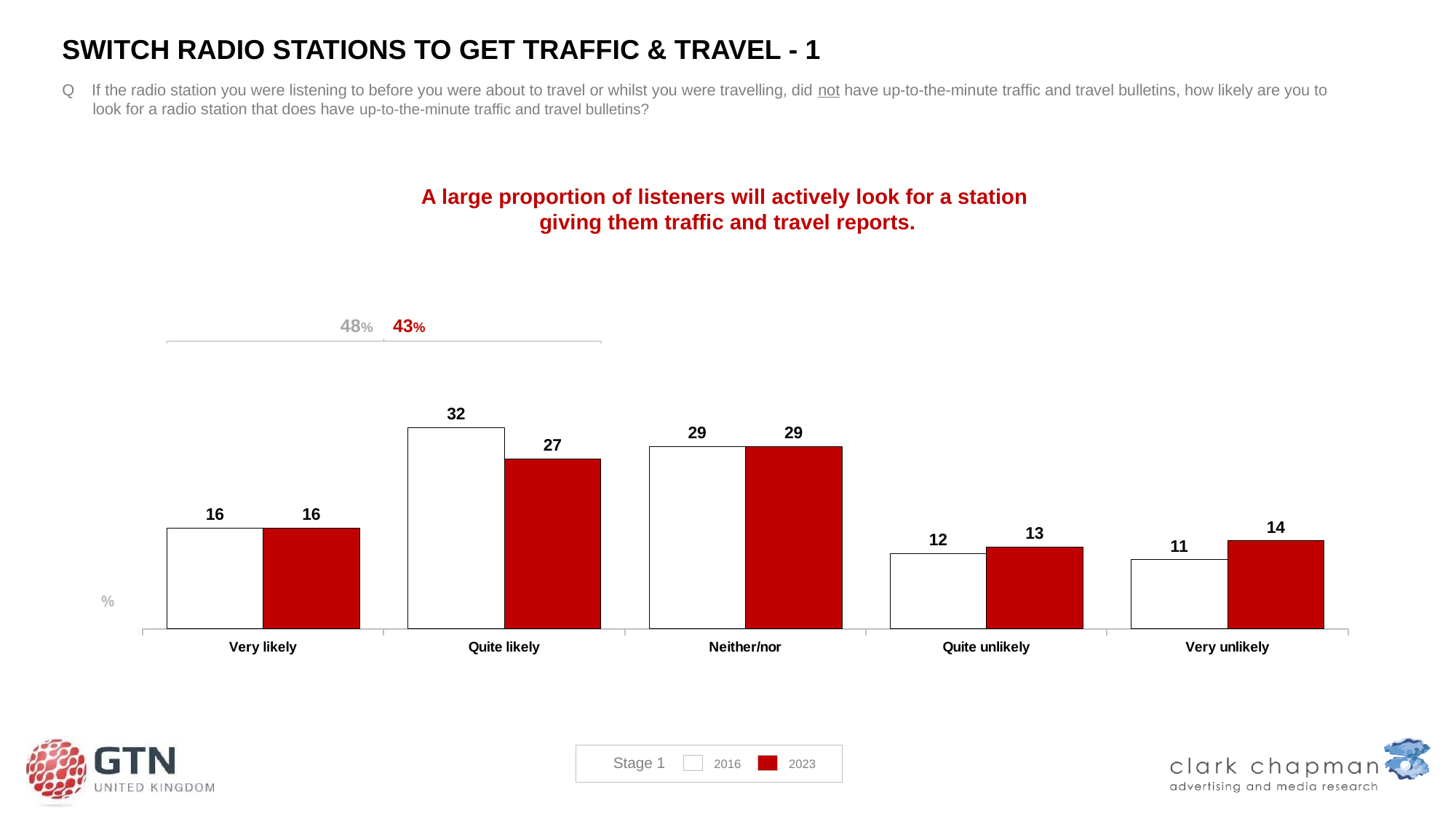
What is the combined 2023 percentage shown above the Very likely and Quite likely bars? 43% How many categories are shown on the x axis? 5 How many series does the legend list? 2 Which category has the highest 2016 value? Quite likely What is the 2023 value for Very unlikely? 14 What is the difference between the 2016 and 2023 values for Quite likely? 5 What is the 2023 value for Neither/nor? 29 What is the 2016 value for Quite likely? 32 Which category has the lowest 2016 value? Very unlikely What kind of chart is shown on the slide? Bar chart Which is larger for Quite unlikely, the 2016 value or the 2023 value? 2023 Which colour represents the 2023 series in the legend? Red